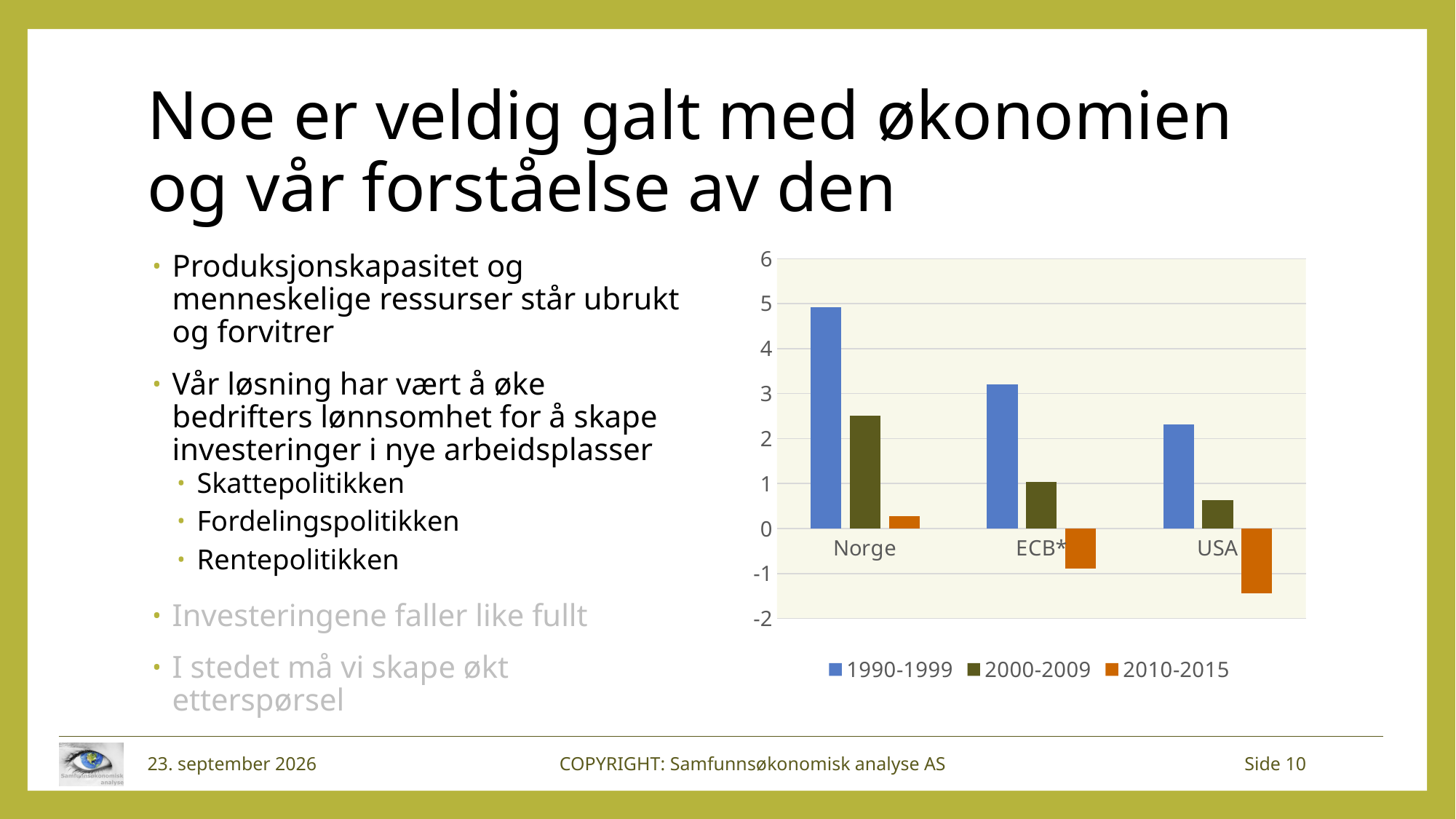
Which is larger: the 2000-2009 value for Norge or the 2000-2009 value for USA? Norge Which category has the highest value for the 1990-1999 series? Norge Which category has the lowest value for the 1990-1999 series? USA How many categories are shown on the x axis of the chart? 3 What kind of chart is shown on the slide? bar chart Do the values for the 1990-1999 series rise or fall from Norge to USA along the x axis? fall Which series is shown in orange in the chart legend? 2010-2015 Is the value for USA in the 2010-2015 series greater or less than -1? less Is the value for Norge in the 1990-1999 series greater or less than 4? greater Is the value for ECB* in the 2000-2009 series greater or less than 2? less How many series does the chart legend list? 3 Which category has the lowest value for the 2010-2015 series? USA